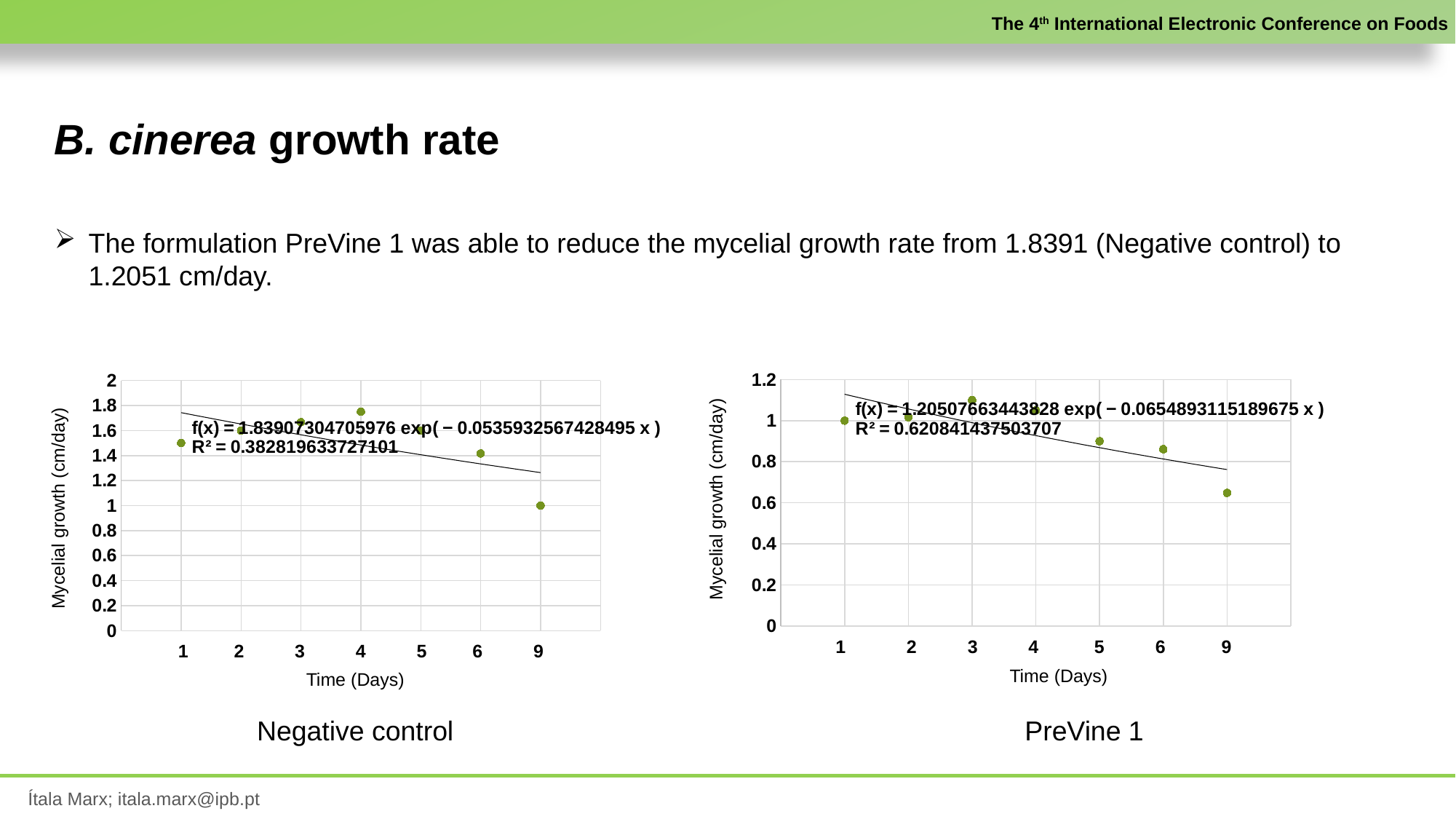
In the Negative control chart, which day has the highest mycelial growth? 4 In the PreVine 1 chart, is the value at day 5 greater or less than 0.8? greater In the PreVine 1 chart, is the value at day 6 larger or smaller than the value at day 9? larger In the Negative control chart, is the value at day 4 greater or less than 1.6? greater In the PreVine 1 chart, is the value at day 9 greater or less than 0.8? less In the PreVine 1 chart, which day has the lowest mycelial growth? 9 What is the x-axis title of the Negative control chart? Time (Days) What is the R² value shown on the PreVine 1 chart? 0.620841437503707 In the Negative control chart, which day has the lowest mycelial growth? 9 In the PreVine 1 chart, which day has the highest mycelial growth? 3 What kind of chart is the Negative control chart? scatter chart